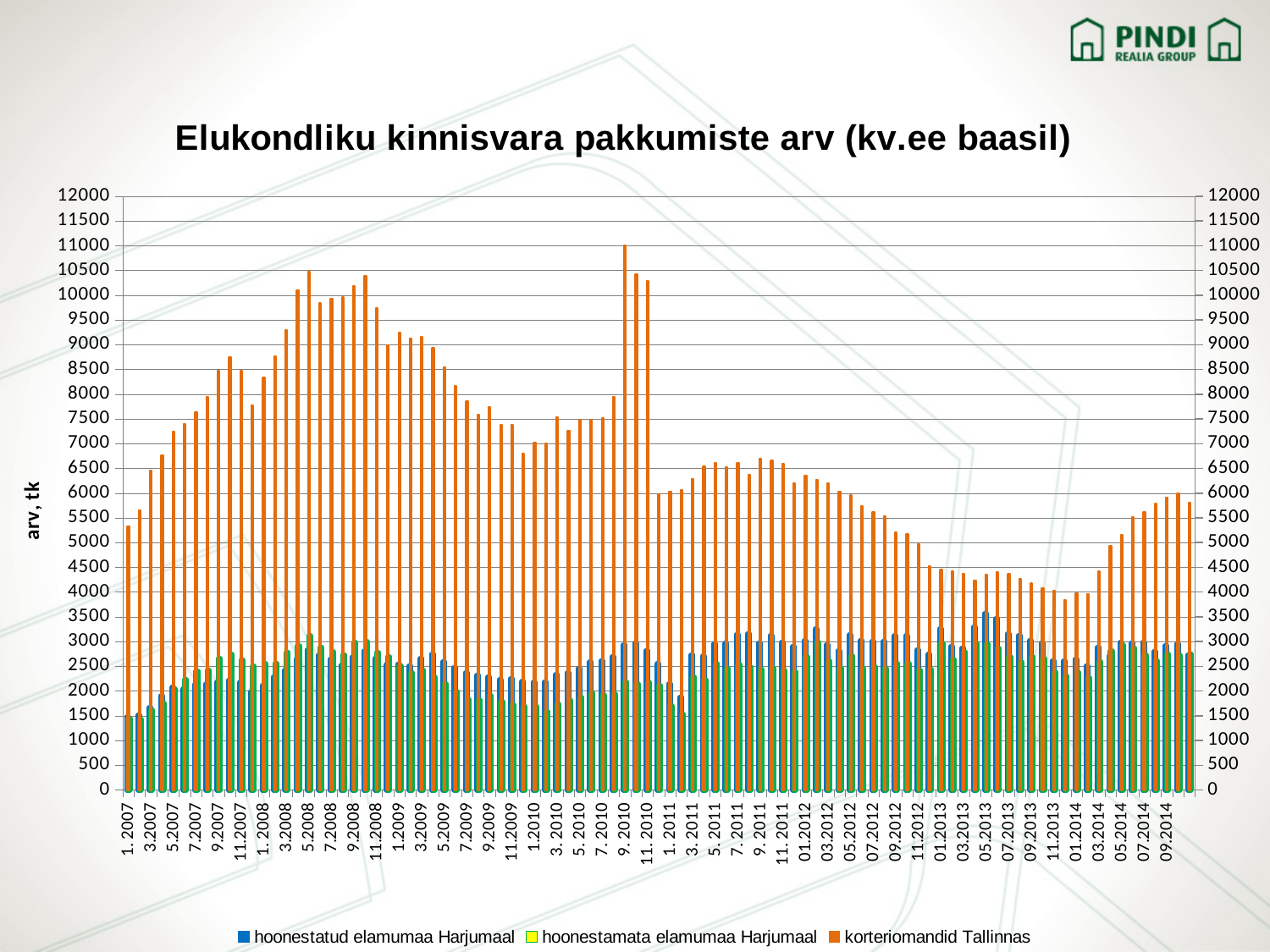
Do the values for korteriomandid Tallinnas rise or fall from 9. 2010 to 11.2013? fall Is the value for korteriomandid Tallinnas in 9. 2010 greater or less than 10000? greater Is the value for korteriomandid Tallinnas in 07.2014 greater or less than 5000? greater Which is larger in 1. 2007: korteriomandid Tallinnas or hoonestatud elamumaa Harjumaal? korteriomandid Tallinnas How many series does the legend list? 3 What is the label of the vertical axis? arv, tk What is the title of the chart? Elukondliku kinnisvara pakkumiste arv (kv.ee baasil) Is the value for korteriomandid Tallinnas in 1. 2007 greater or less than 5000? greater Which month has the highest value for korteriomandid Tallinnas? 9. 2010 What kind of chart is shown on the slide? bar chart